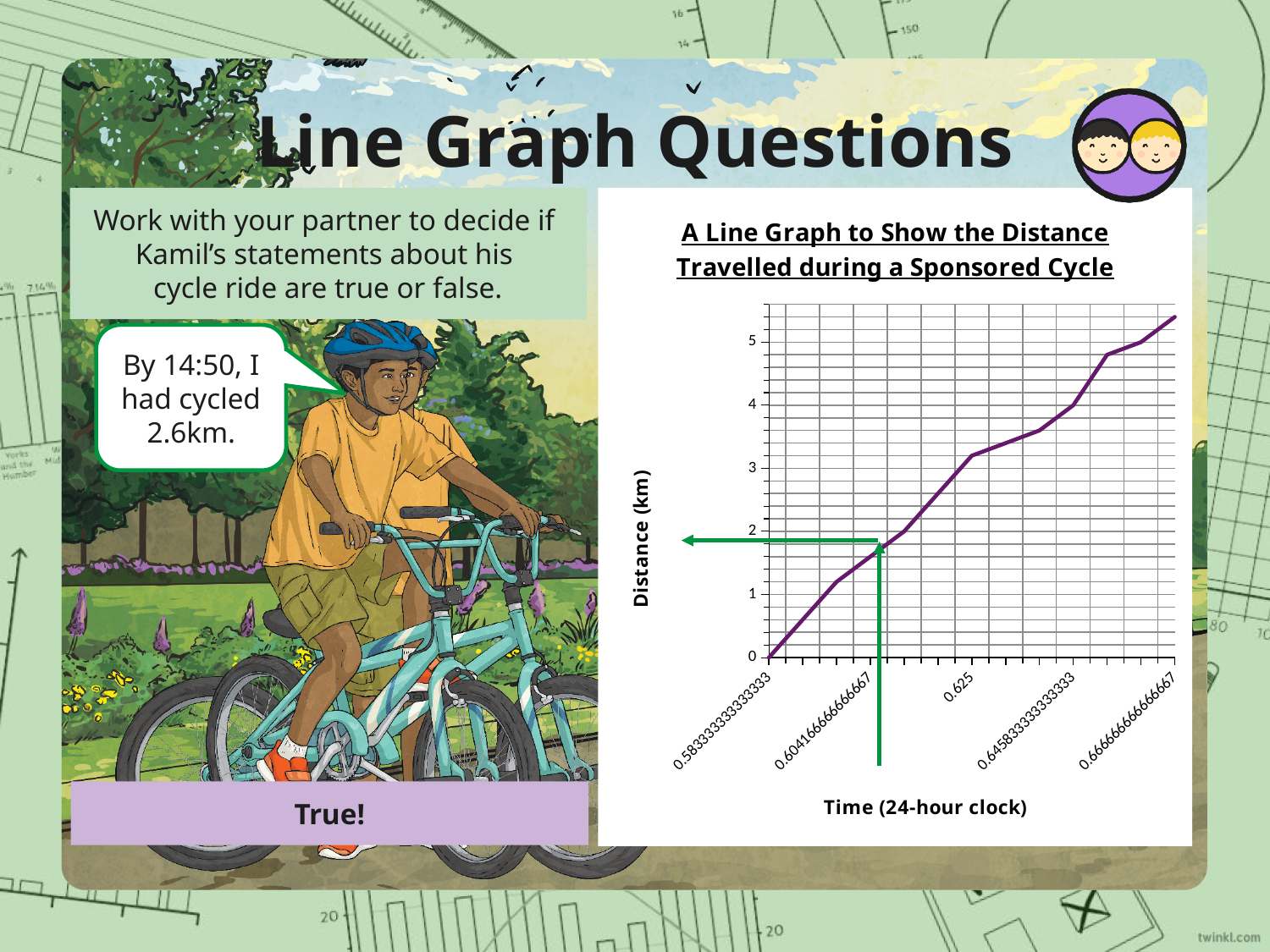
At which x-axis label is the plotted distance highest? 0.666666666666667 Is the distance at 0.604166666666667 greater or less than 2? less At which x-axis label is the plotted distance lowest? 0.583333333333333 Is the distance at 0.666666666666667 greater or less than 5? greater What is the title of the chart? A Line Graph to Show the Distance Travelled during a Sponsored Cycle What distance is plotted at the first time point, 0.583333333333333? 0 Does the distance rise or fall as time increases along the x axis? rise Is the distance at 0.625 greater or less than 4? less Which has the larger plotted distance, 0.625 or 0.604166666666667? 0.625 Does the line ever fall between consecutive points? no What is the label on the x axis of the chart? Time (24-hour clock) What kind of chart is shown on the slide? line chart